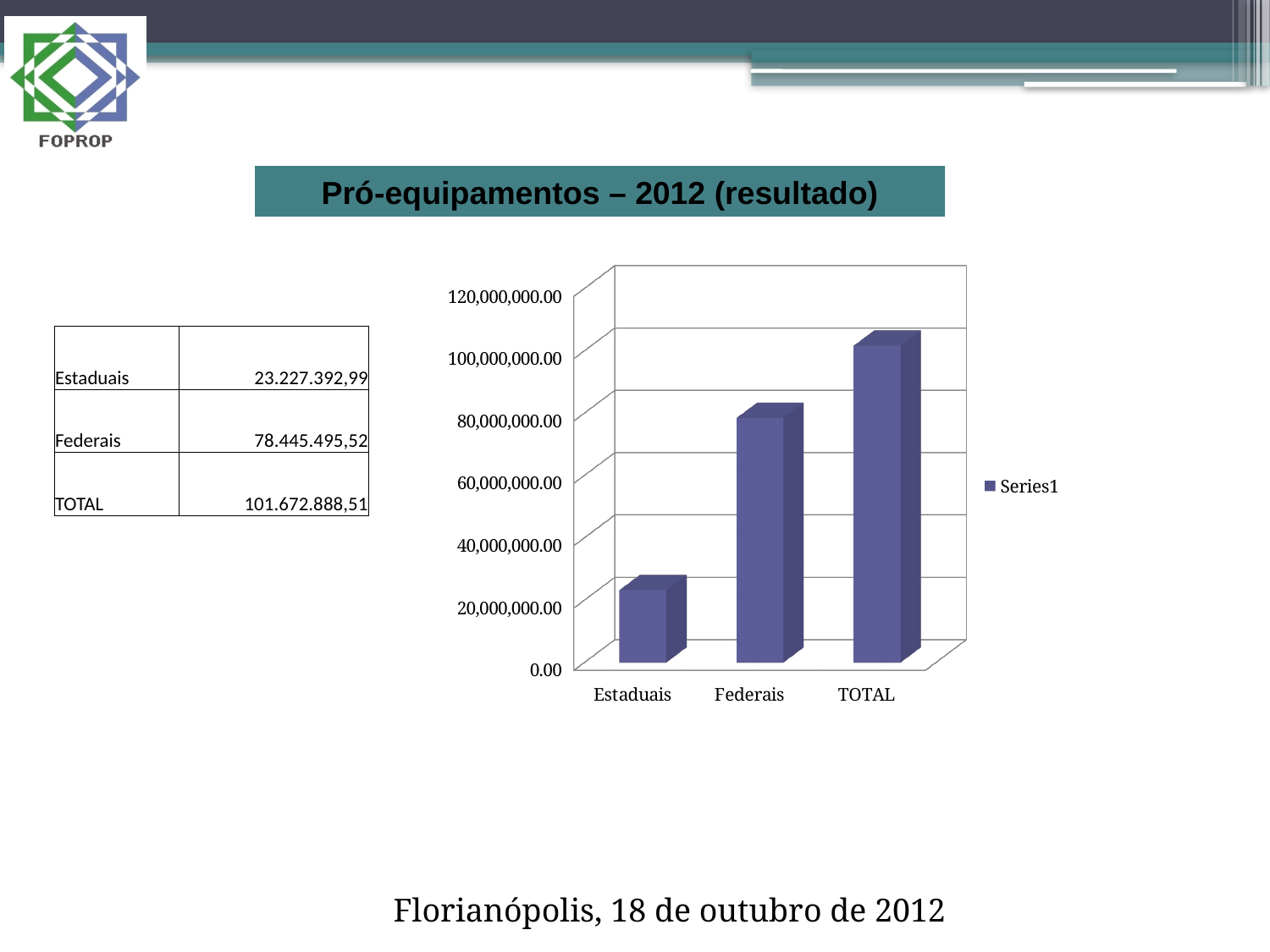
Is the bar for Estaduais greater or less than 40,000,000.00? less Which category has the highest bar in the chart? TOTAL What is the name of the series shown in the chart legend? Series1 How many categories are plotted on the x axis of the chart? 3 Do the bar values rise or fall from left to right across the x axis? rise Is the bar for Federais greater or less than 60,000,000.00? greater What kind of chart is shown on the slide? bar chart Is the bar for TOTAL greater or less than 100,000,000.00? greater How many series does the chart legend list? 1 Which category has the lowest bar in the chart? Estaduais Which is larger, the bar for Estaduais or the bar for Federais? Federais According to the table on the slide, what is the value for Federais? 78.445.495,52